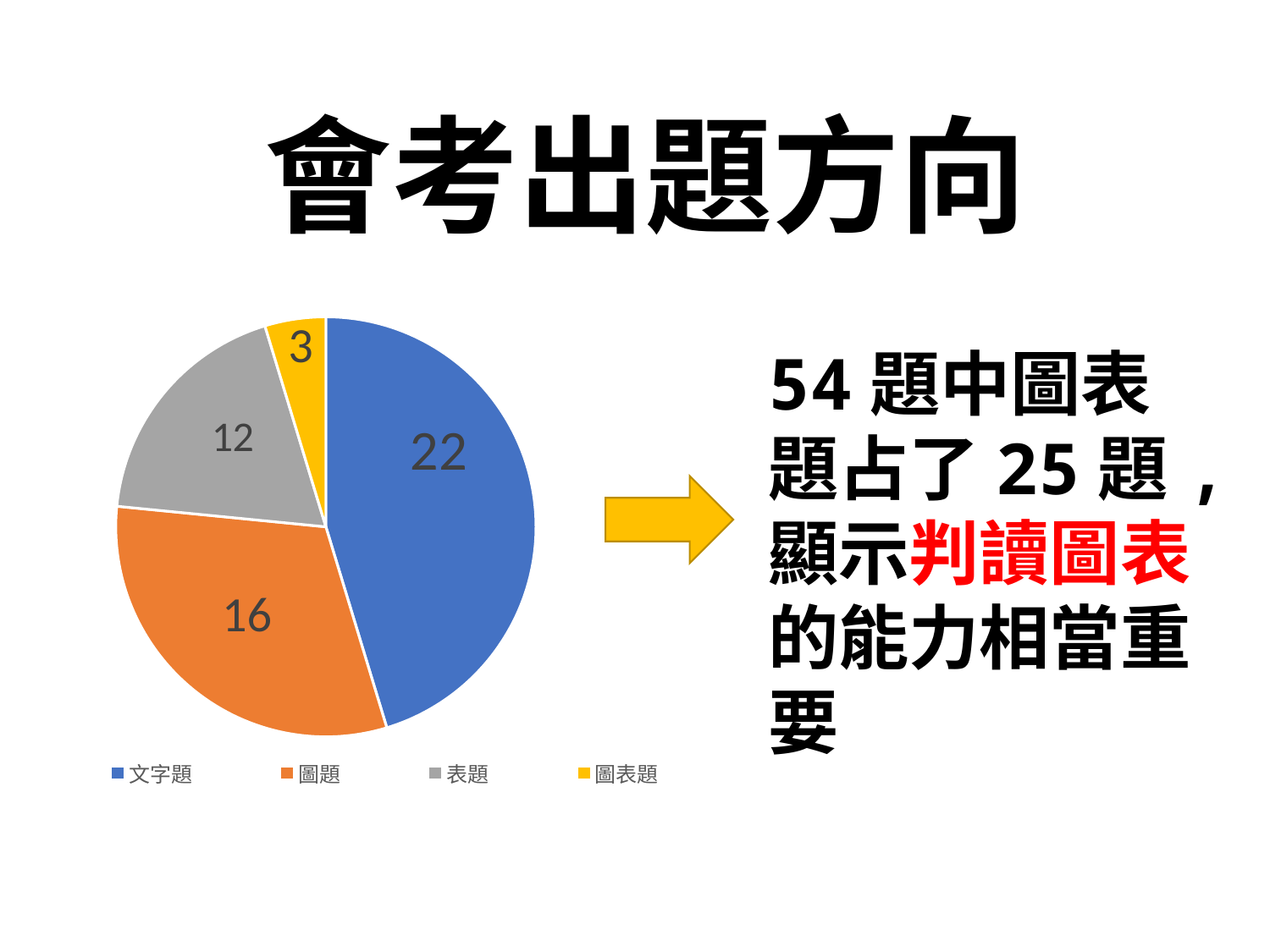
What colour is the slice for 圖表題 in the pie chart? Yellow What is the value for 圖題 in the pie chart? 16 What kind of chart is shown on the slide? Pie chart Which category has the largest slice in the pie chart? 文字題 Which is larger, the value for 圖題 or the value for 表題? 圖題 How many categories does the pie chart show? 4 What is the difference between the values for 文字題 and 圖題? 6 What is the value for 表題 in the pie chart? 12 What is the difference between the values for 表題 and 圖表題? 9 What is the value for 圖表題 in the pie chart? 3 What is the value for 文字題 in the pie chart? 22 Which category has the smallest slice in the pie chart? 圖表題